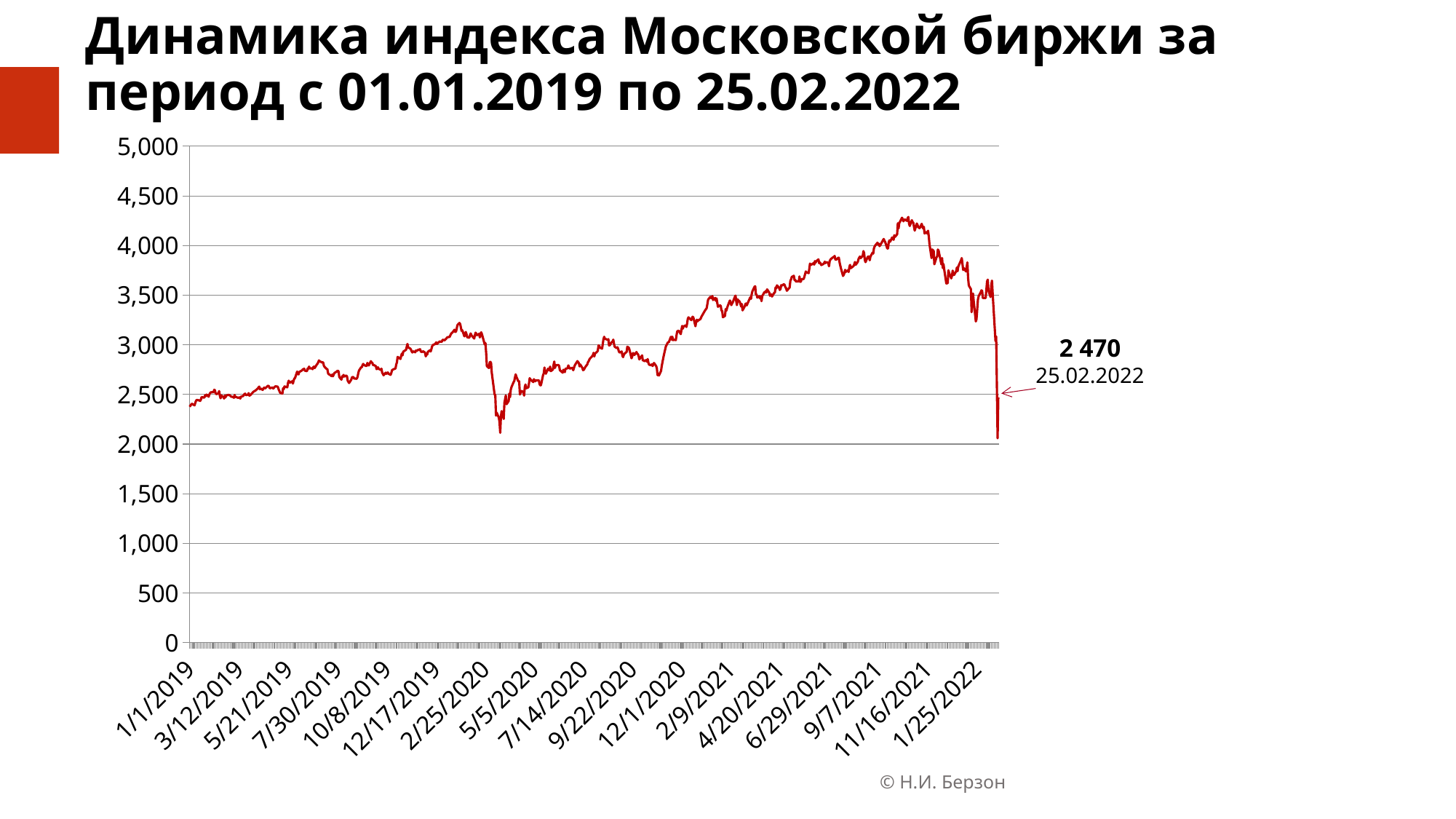
What value of the Moscow Exchange index is annotated on the chart for 25.02.2022? 2 470 What kind of chart is shown on the slide? line chart Is the peak value of the index in late 2021 greater or less than 4,000? greater What colour is the line plotted on the chart? red On which date does the annotated value 2 470 fall? 25.02.2022 Is the lowest value of the index in the dip around March 2020 greater or less than 2,500? less Does the index generally rise or fall between 1/1/2019 and 12/17/2019? rise Is the value of the index around 9/7/2021 greater or less than 3,500? greater What is the highest value shown on the y axis? 5,000 How many date labels are shown on the x axis? 17 Does the index rise or fall between 11/16/2021 and 1/25/2022? fall